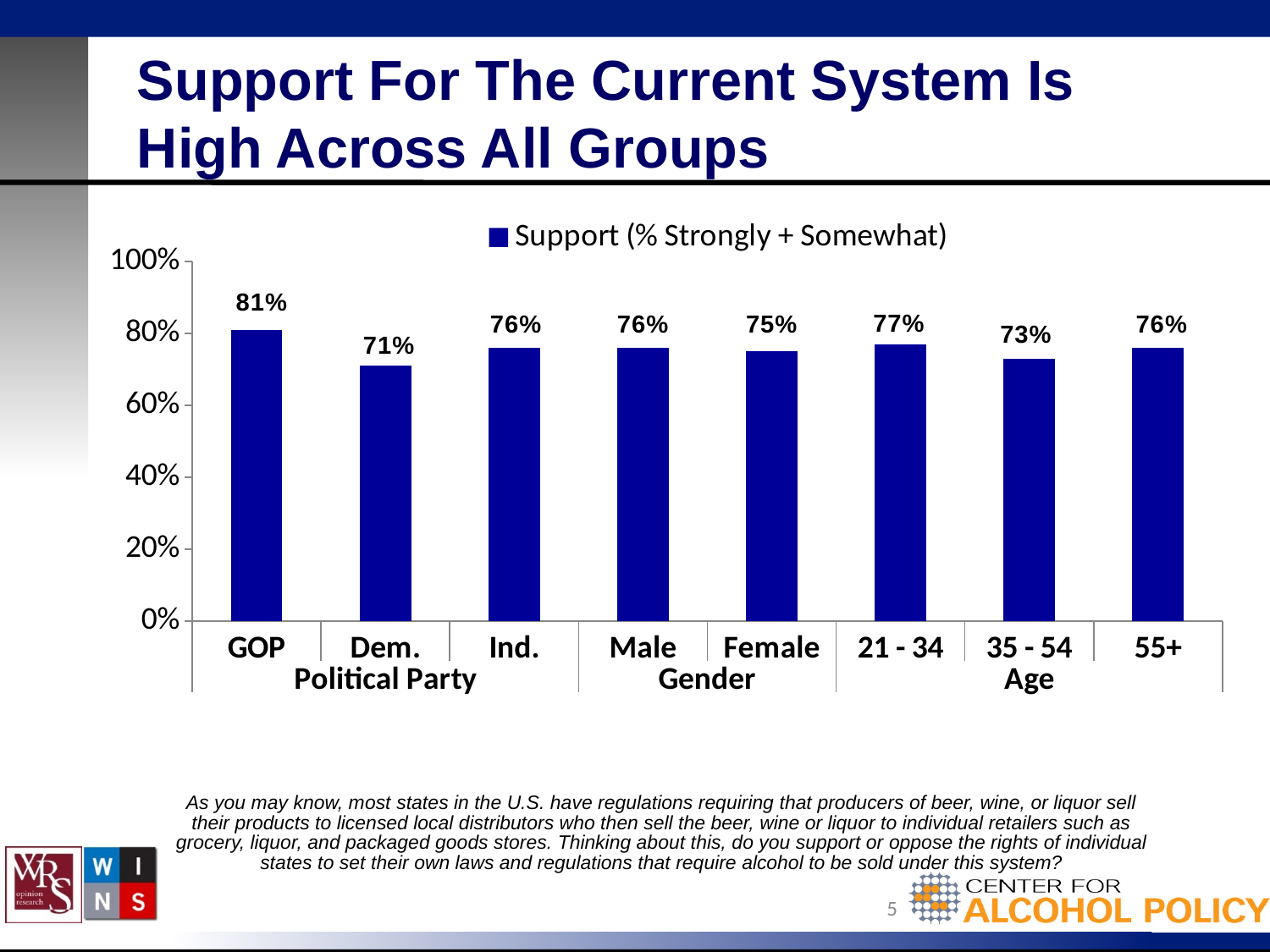
What is the support value for GOP? 81% What is the legend entry for the series shown in the chart? Support (% Strongly + Somewhat) What is the support value for the 35 - 54 age group? 73% Is the value for Dem. greater or less than 80%? less What is the difference between the support values for GOP and Dem.? 10% How many groups (bars) are shown in the chart? 8 What is the support value for Dem.? 71% What kind of chart is shown on the slide? Bar chart Which group has the lowest support value? Dem. Which group has the highest support value? GOP Which has a higher support value, 21 - 34 or 35 - 54? 21 - 34 What is the support value for Female? 75%